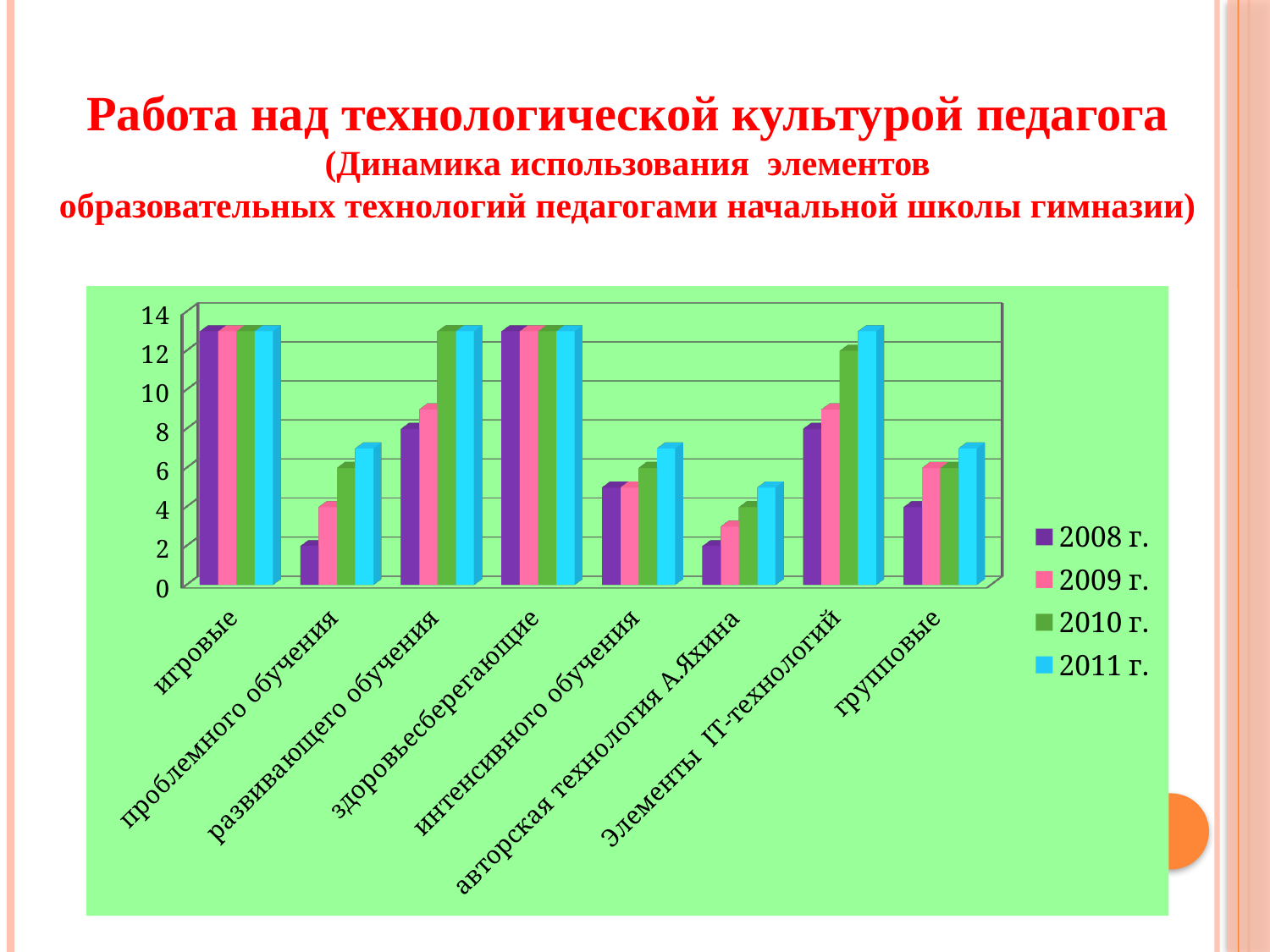
Which category has the lowest 2011 г. value? авторская технология А.Яхина Is the 2011 г. value for 'Элементы IT-технологий' greater or less than 10? greater What kind of chart is shown on the slide? bar chart How many series does the legend list? 4 Is the 2008 г. value for 'интенсивного обучения' greater or less than 6? less What are the legend entries of the chart? 2008 г., 2009 г., 2010 г., 2011 г. Is the 2008 г. value for 'проблемного обучения' greater or less than 4? less Which is larger for 2008 г.: 'игровые' or 'групповые'? игровые Do the values for 'Элементы IT-технологий' rise or fall from 2008 г. to 2011 г.? rise Which is larger for 2009 г.: 'развивающего обучения' or 'проблемного обучения'? развивающего обучения How many categories are shown along the x axis? 8 Do the values for 'проблемного обучения' rise or fall from 2008 г. to 2011 г.? rise